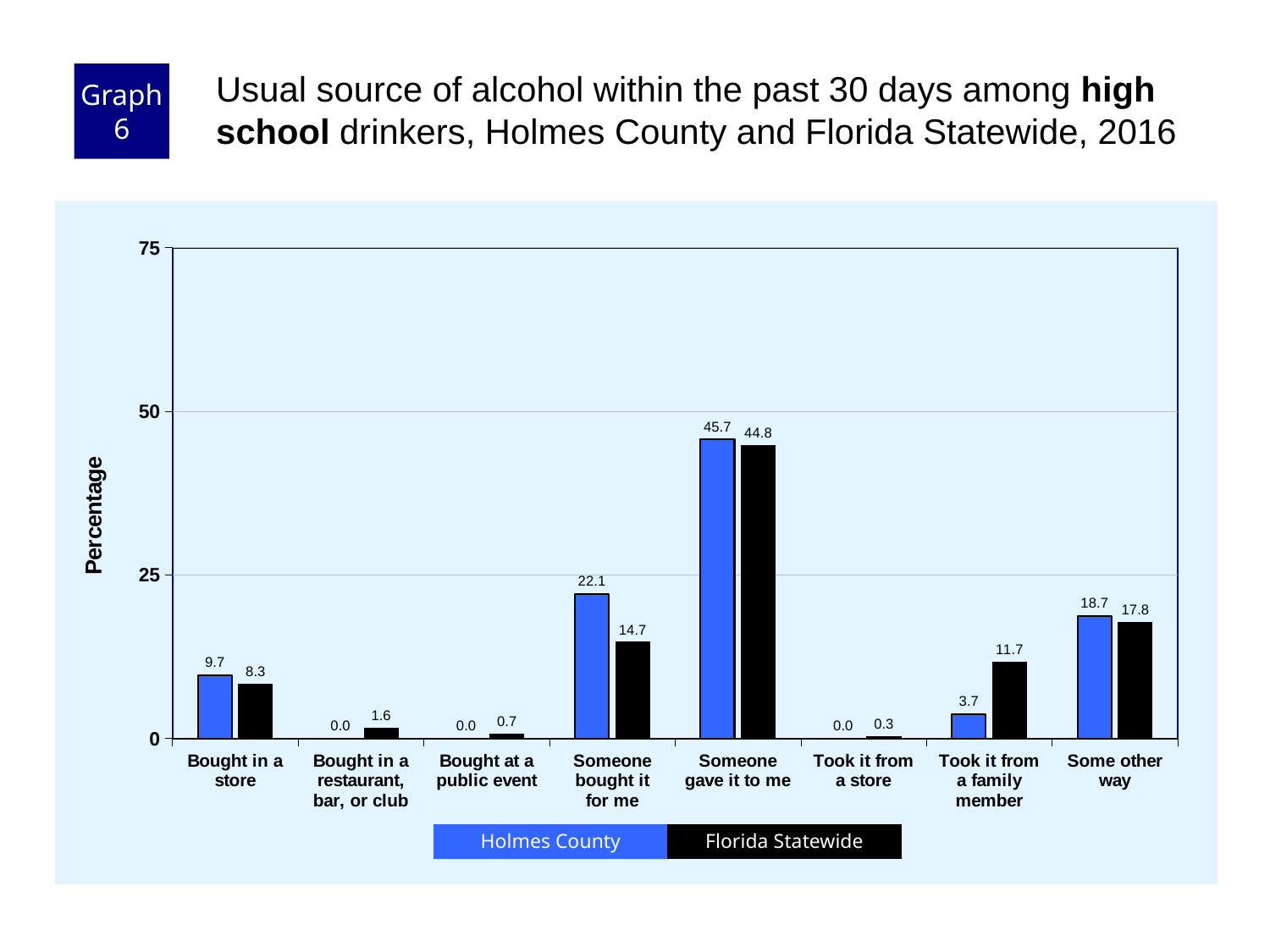
How many series does the legend list? 2 How many categories are shown on the x axis? 8 What is the Florida Statewide value for "Someone bought it for me"? 14.7 What is the difference between the Holmes County and Florida Statewide values for "Someone bought it for me"? 7.4 What kind of chart is shown on the slide? bar chart What is the label on the y axis? Percentage What is the Florida Statewide value for "Took it from a family member"? 11.7 What is the Holmes County value for "Someone gave it to me"? 45.7 Is the Holmes County value for "Someone gave it to me" greater or less than 50? less Which is larger for "Took it from a family member": Holmes County or Florida Statewide? Florida Statewide Which category has the lowest Florida Statewide value? Took it from a store Which category has the highest Holmes County value? Someone gave it to me